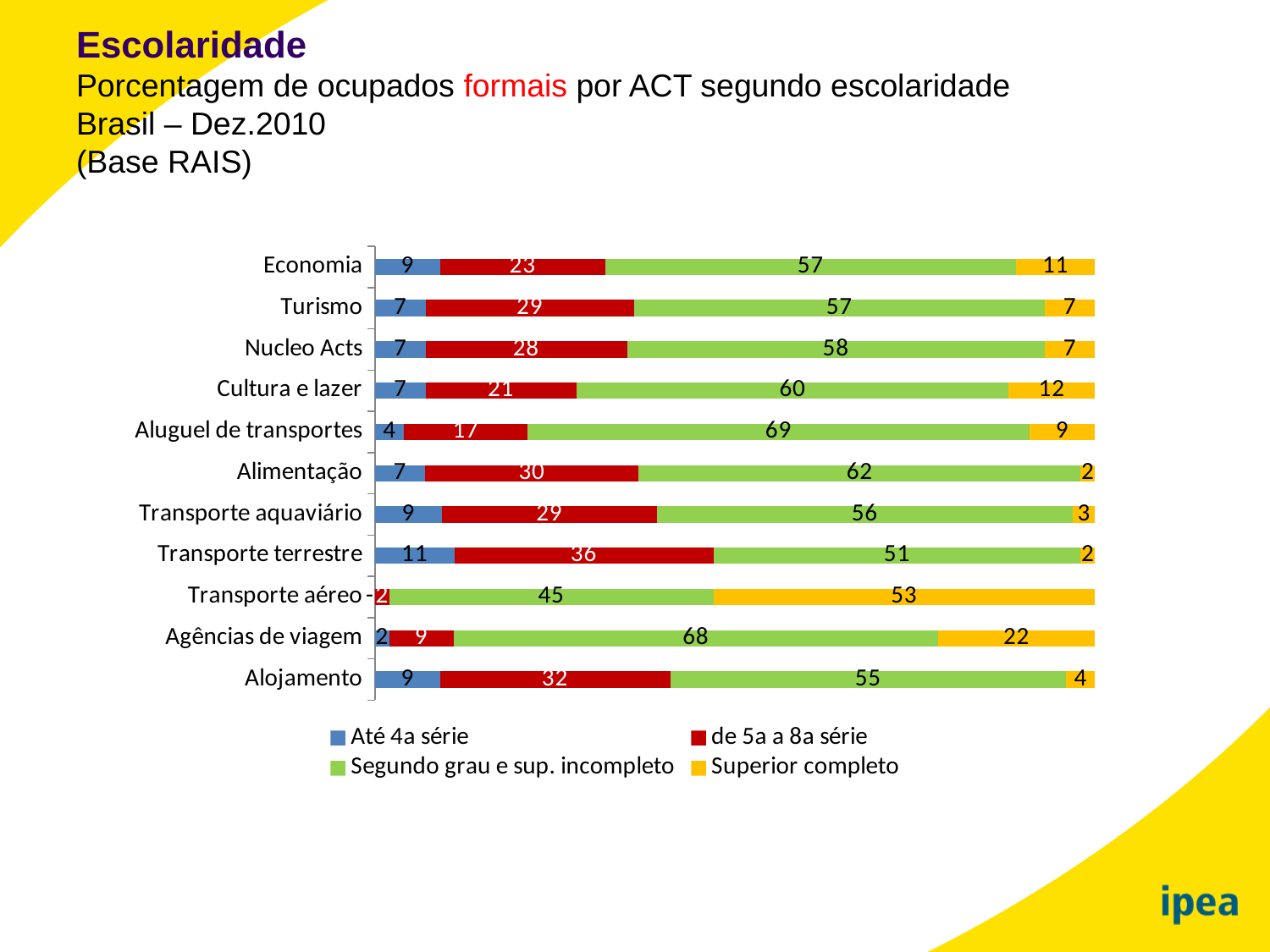
Which category has the highest value for de 5a a 8a série? Transporte terrestre Which has a larger Segundo grau e sup. incompleto value, Alimentação or Cultura e lazer? Alimentação How many series does the legend list? 4 What is the value of Segundo grau e sup. incompleto for Aluguel de transportes? 69 Which category has the highest value for Superior completo? Transporte aéreo What is the value of Superior completo for Transporte aéreo? 53 What is the total of the stacked bar for Economia? 100 Which category has the lowest value for Segundo grau e sup. incompleto? Transporte aéreo What is the value of Até 4a série for Transporte terrestre? 11 How many categories are shown on the chart? 11 What kind of chart is shown on the slide? Stacked bar chart What is the difference between the Superior completo values for Agências de viagem and Cultura e lazer? 10